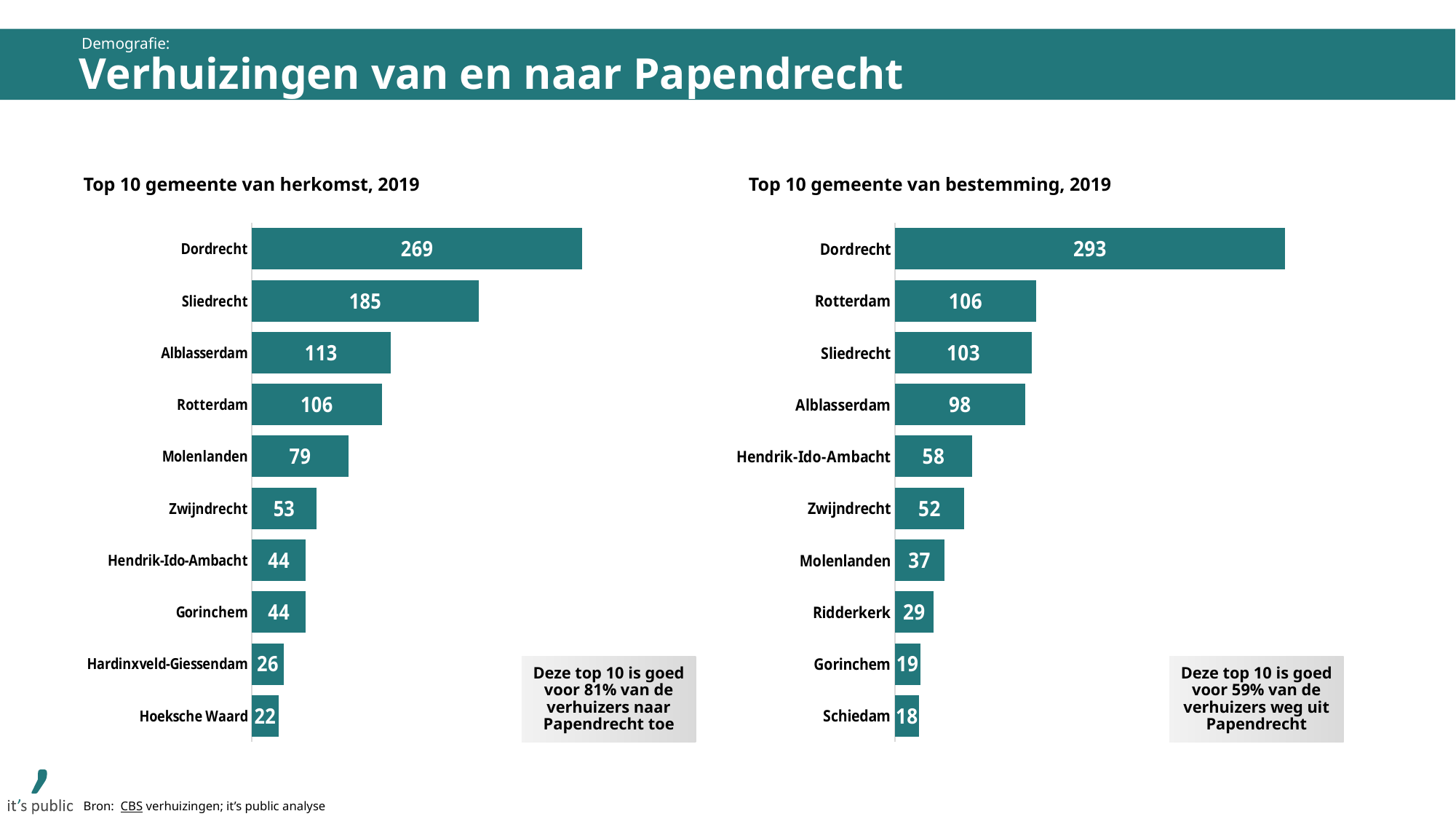
In the chart 'Top 10 gemeente van bestemming, 2019', which municipality has the lowest value? Schiedam In the chart 'Top 10 gemeente van herkomst, 2019', what is the value for Sliedrecht? 185 In the chart 'Top 10 gemeente van herkomst, 2019', which municipality has the highest value? Dordrecht How many municipalities are shown in the chart 'Top 10 gemeente van herkomst, 2019'? 10 What kind of chart is 'Top 10 gemeente van bestemming, 2019'? Bar chart In the chart 'Top 10 gemeente van bestemming, 2019', what is the difference between the values for Rotterdam and Sliedrecht? 3 In the chart 'Top 10 gemeente van bestemming, 2019', which is larger: the value for Molenlanden or the value for Zwijndrecht? Zwijndrecht In the chart 'Top 10 gemeente van herkomst, 2019', what is the difference between the values for Dordrecht and Sliedrecht? 84 According to the text box next to the chart 'Top 10 gemeente van bestemming, 2019', what share of the movers leaving Papendrecht does this top 10 account for? 59% In the chart 'Top 10 gemeente van herkomst, 2019', what is the value for Hoeksche Waard? 22 In the chart 'Top 10 gemeente van herkomst, 2019', which is larger: the value for Alblasserdam or the value for Rotterdam? Alblasserdam In the chart 'Top 10 gemeente van bestemming, 2019', what is the value for Hendrik-Ido-Ambacht? 58